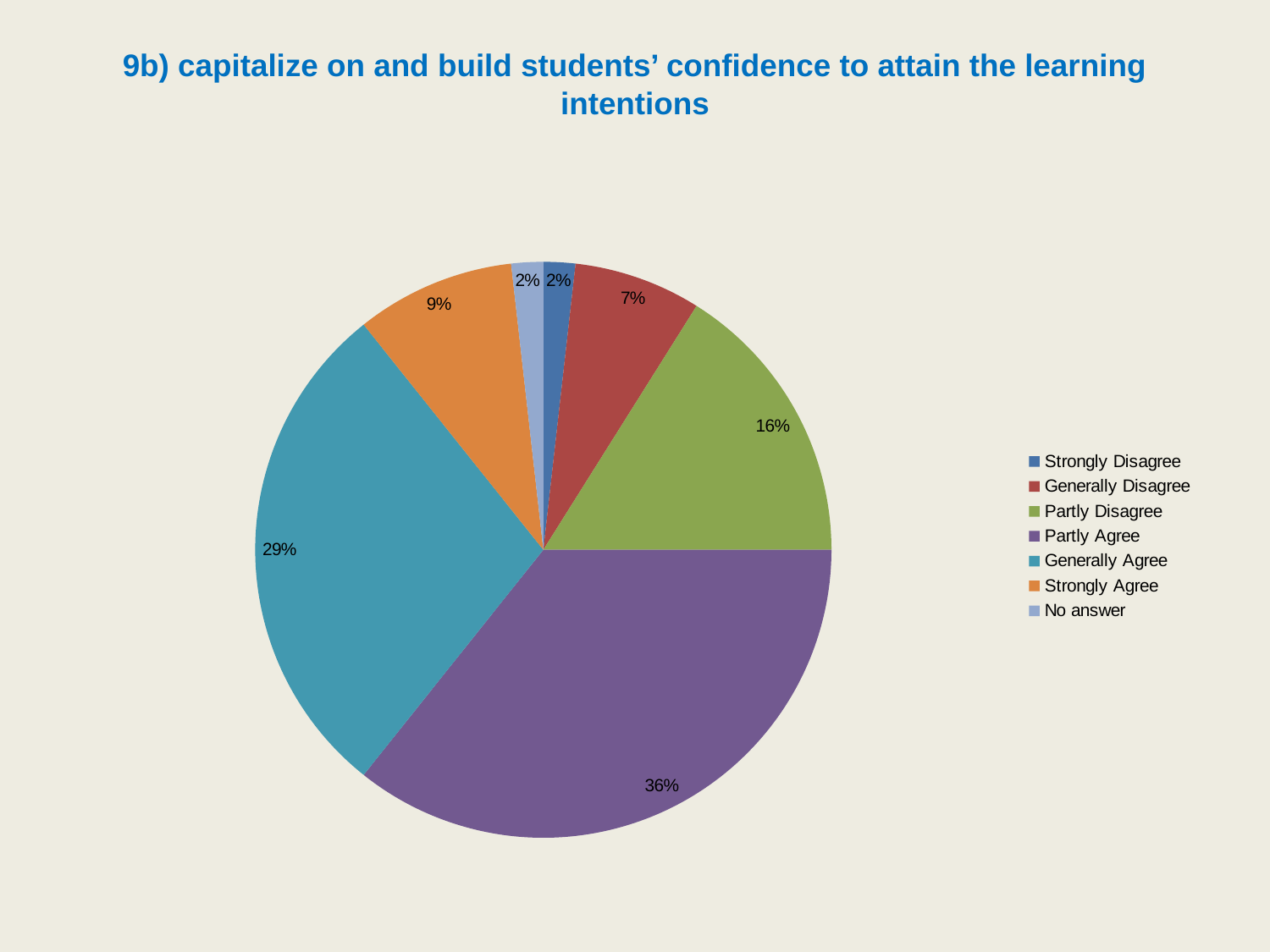
What is the difference between the Partly Agree and Generally Agree percentages? 7% What is the value shown for Partly Disagree? 16% What is the combined share of Partly Agree and Generally Agree? 65% What is the value for Generally Disagree? 7% How many categories does the pie chart show? 7 What share does Generally Agree have in the pie chart? 29% What percentage is labelled for Strongly Agree? 9% Which category has the largest slice of the pie? Partly Agree What type of chart is shown on the slide? Pie chart Which is larger, Partly Disagree or Strongly Agree? Partly Disagree What percentage of the pie chart is Partly Agree? 36% Which colour represents Generally Agree in the legend? Teal